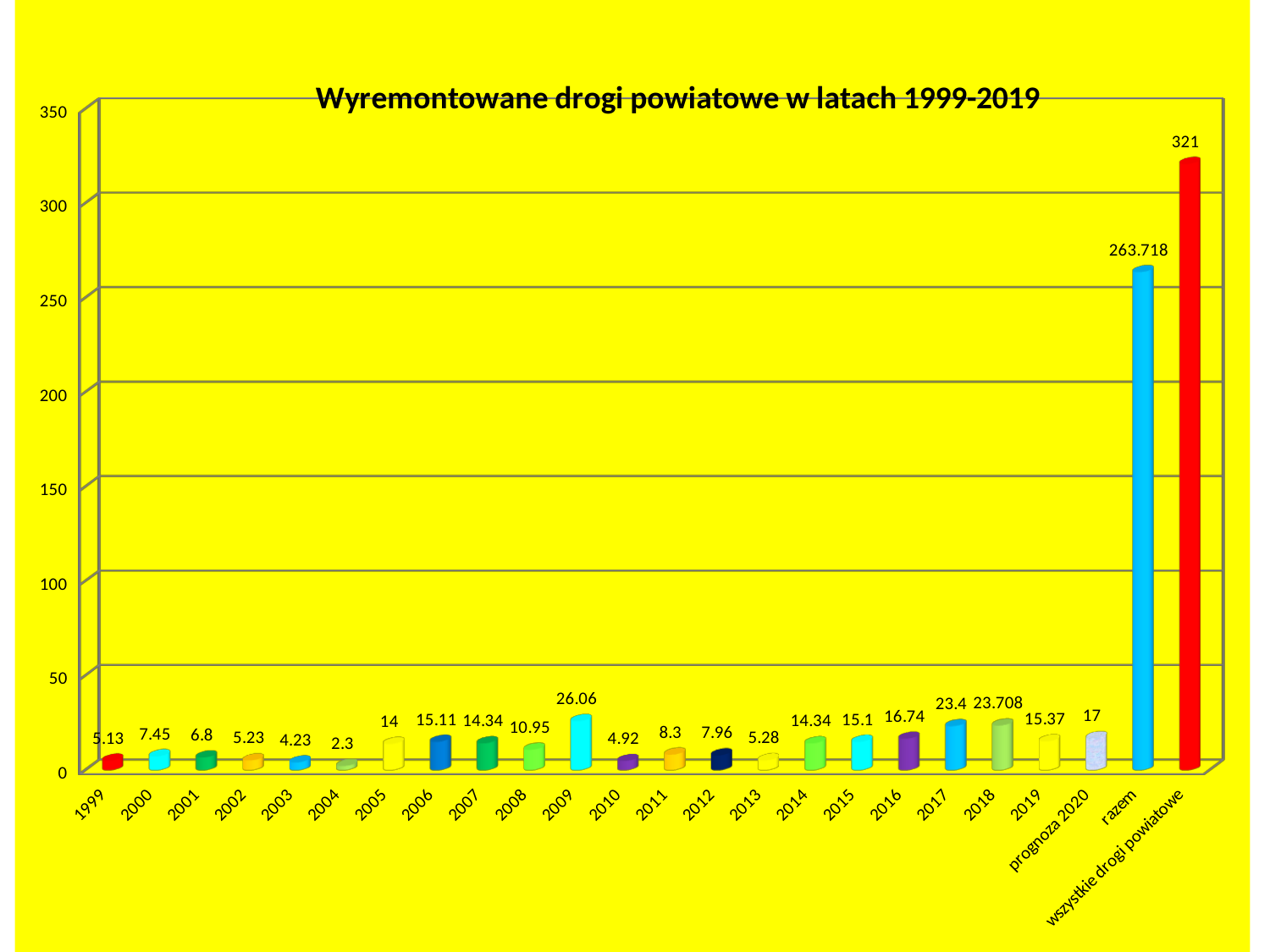
Which is larger, the value for 2017 or for 2018? 2018 Which year between 1999 and 2019 has the highest value? 2009 What is the value for 2009? 26.06 Which year between 1999 and 2019 has the lowest value? 2004 Is the value for 'razem' greater or less than 250? greater How many bars are shown on the chart? 24 What is the difference between 'wszystkie drogi powiatowe' and 'razem'? 57.282 What is the value for the 'razem' bar? 263.718 What kind of chart is shown? bar chart Which category has the highest value? wszystkie drogi powiatowe What is the value for 'prognoza 2020'? 17 Do the values rise or fall from 2013 to 2016? rise